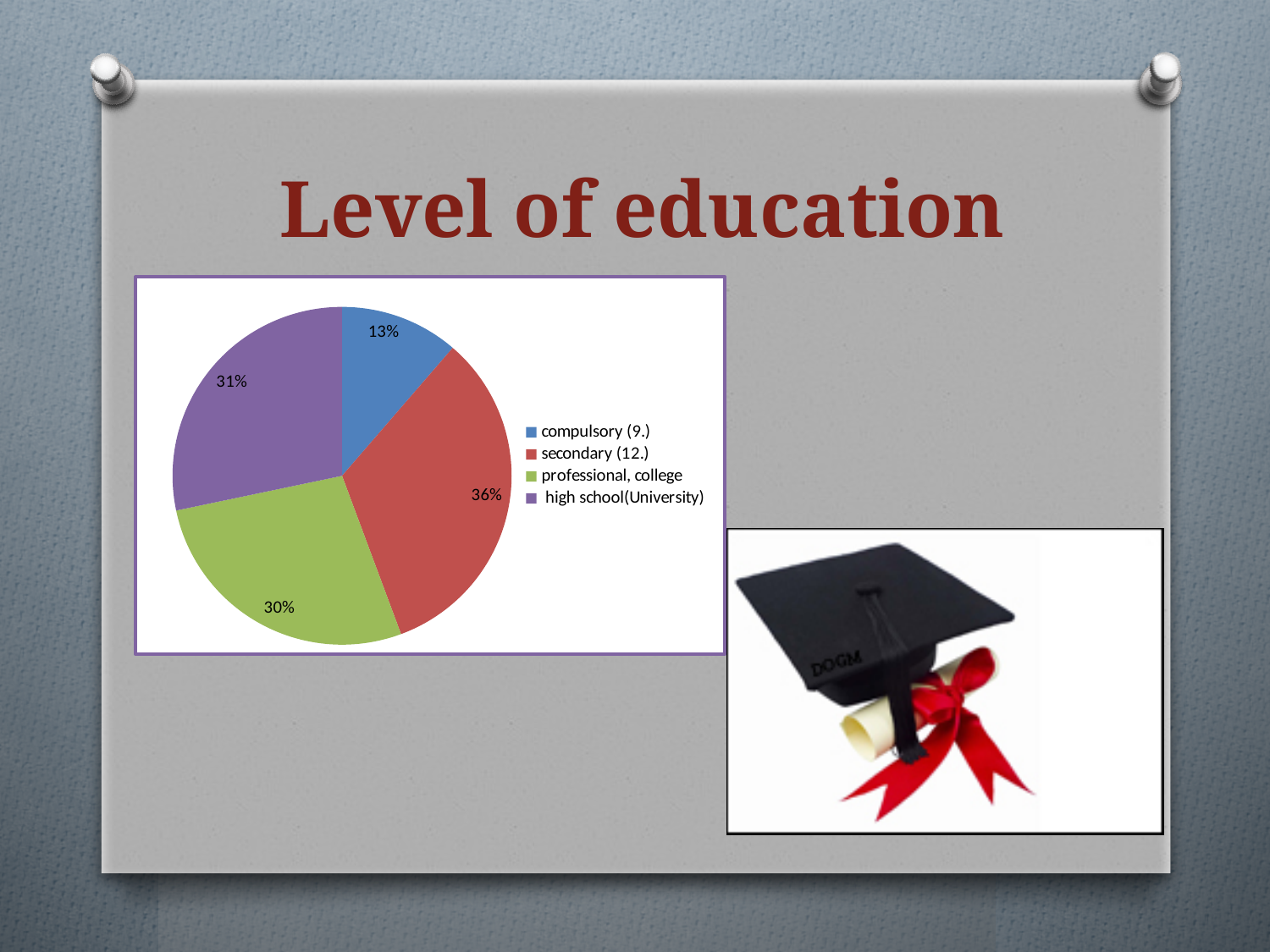
What colour is the slice for high school(University) in the pie chart? purple Which level of education has the largest slice of the pie? secondary (12.) Which level of education has the smallest slice of the pie? compulsory (9.) What is the difference in percentage points between the secondary (12.) slice and the compulsory (9.) slice? 23% What kind of chart is shown on the slide? pie chart What share of the pie does the high school(University) slice represent? 31% Which slice is larger, secondary (12.) or professional, college? secondary (12.) What is the title of the slide containing the pie chart? Level of education What share of the pie does the secondary (12.) slice represent? 36% What share of the pie does the compulsory (9.) slice represent? 13% How many slices does the pie chart have? 4